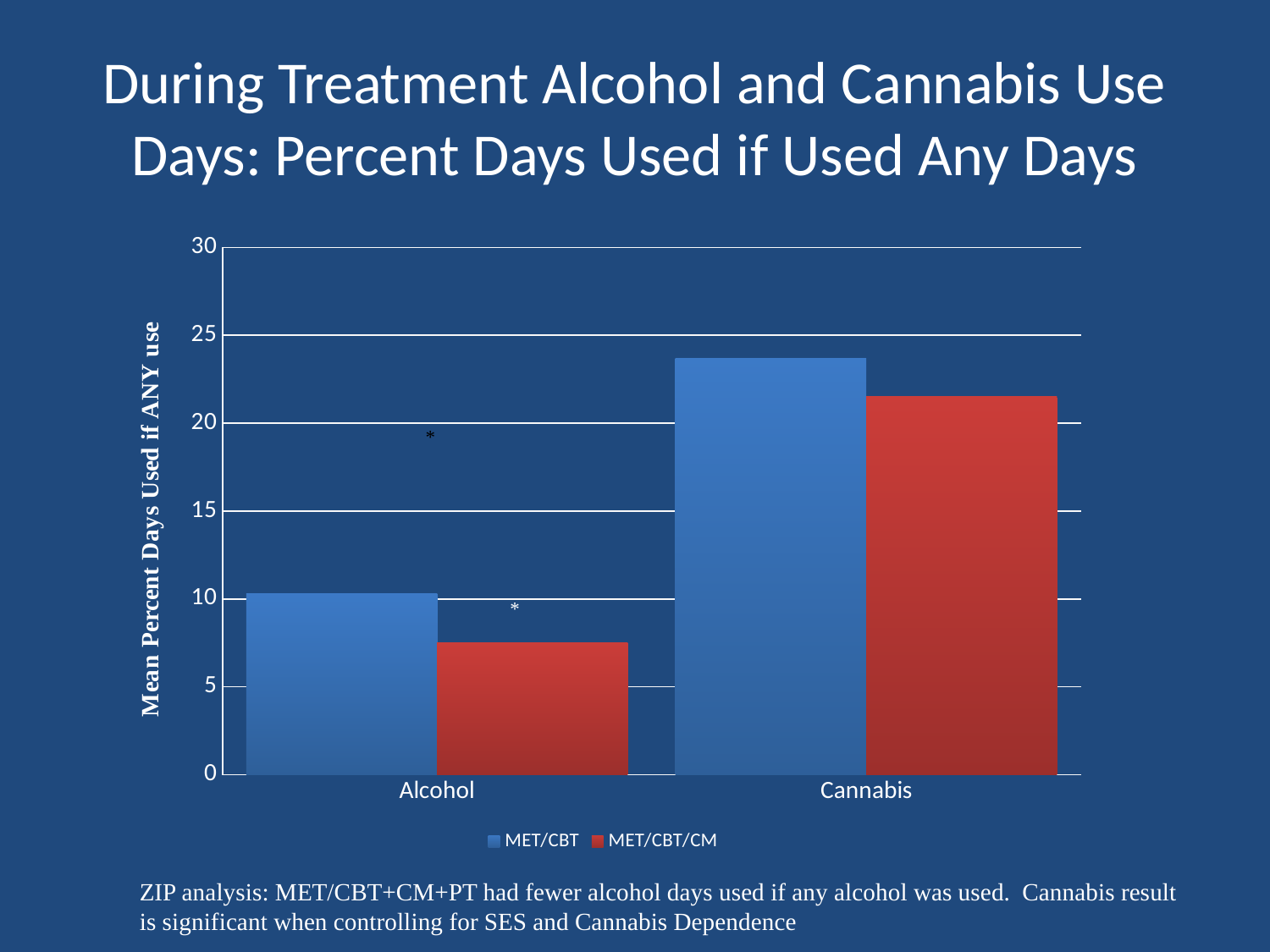
What is the label on the vertical axis of the chart? Mean Percent Days Used if ANY use For Alcohol, which series has the larger value, MET/CBT or MET/CBT/CM? MET/CBT Which category and series has the highest bar in the chart? Cannabis, MET/CBT Which category and series has the lowest bar in the chart? Alcohol, MET/CBT/CM Is the MET/CBT/CM value for Alcohol greater or less than 10? less Is the MET/CBT/CM value for Cannabis greater or less than 25? less How many series does the chart's legend list? 2 Is the MET/CBT value for Cannabis greater or less than 20? greater How many categories are shown on the x axis of the chart? 2 What kind of chart is shown on the slide? Bar chart For Cannabis, which series has the larger value, MET/CBT or MET/CBT/CM? MET/CBT